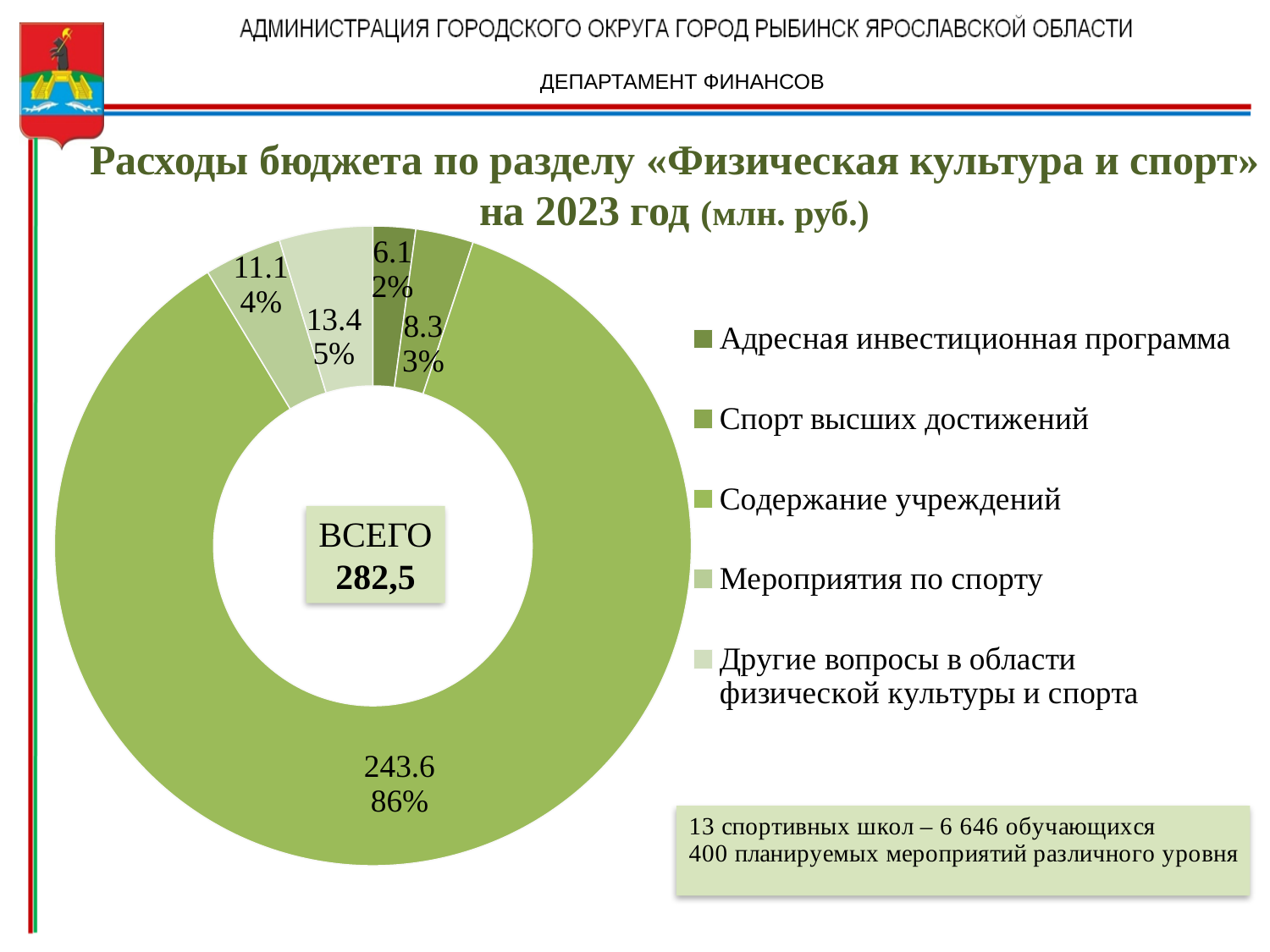
What is the value for «Мероприятия по спорту»? 11.1 What percentage share is shown for «Другие вопросы в области физической культуры и спорта»? 5% What is the value for «Содержание учреждений»? 243.6 What total (ВСЕГО) is shown in the centre of the chart? 282,5 What is the value for «Адресная инвестиционная программа»? 6.1 Which category has the smallest slice? Адресная инвестиционная программа Which category has the largest slice? Содержание учреждений How many categories does the legend list? 5 What is the difference between the values for «Другие вопросы в области физической культуры и спорта» and «Мероприятия по спорту»? 2.3 What share of the total does «Содержание учреждений» account for? 86% What is the value for «Спорт высших достижений»? 8.3 What kind of chart is shown on the slide? doughnut (pie) chart